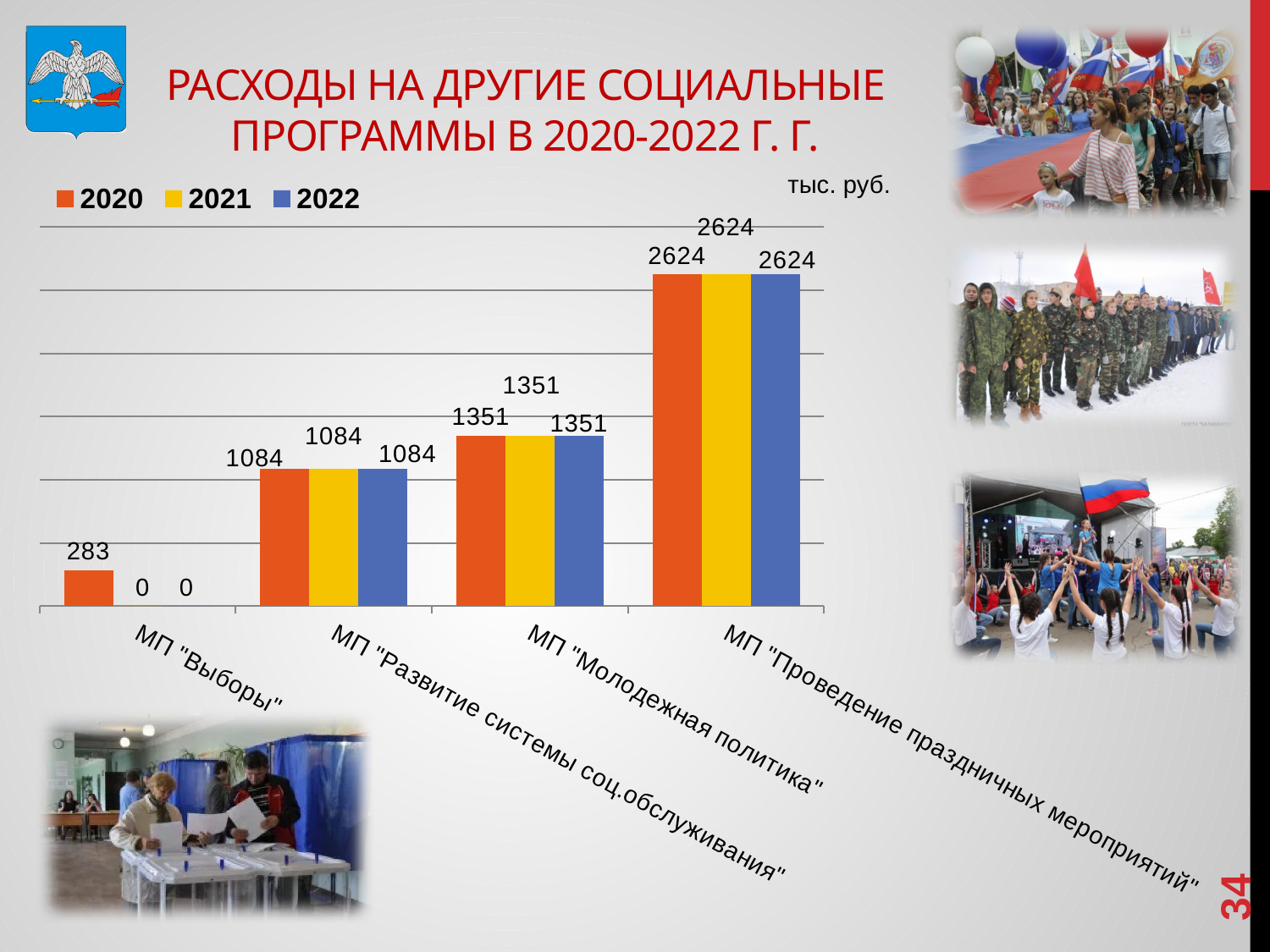
What is the value for МП "Выборы" in 2021? 0 Which is larger in 2021: МП "Развитие системы соц.обслуживания" or МП "Молодежная политика"? МП "Молодежная политика" What is the value for МП "Проведение праздничных мероприятий" in 2021? 2624 What is the value for МП "Развитие системы соц.обслуживания" in 2020? 1084 What is the value for МП "Выборы" in 2020? 283 What is the difference between the 2020 values for МП "Проведение праздничных мероприятий" and МП "Молодежная политика"? 1273 Which category has the highest value in 2022? МП "Проведение праздничных мероприятий" What kind of chart is shown on the slide? bar chart How many series does the legend list? 3 How many categories are shown on the x axis? 4 Which category has the lowest value in 2020? МП "Выборы" What is the value for МП "Молодежная политика" in 2022? 1351